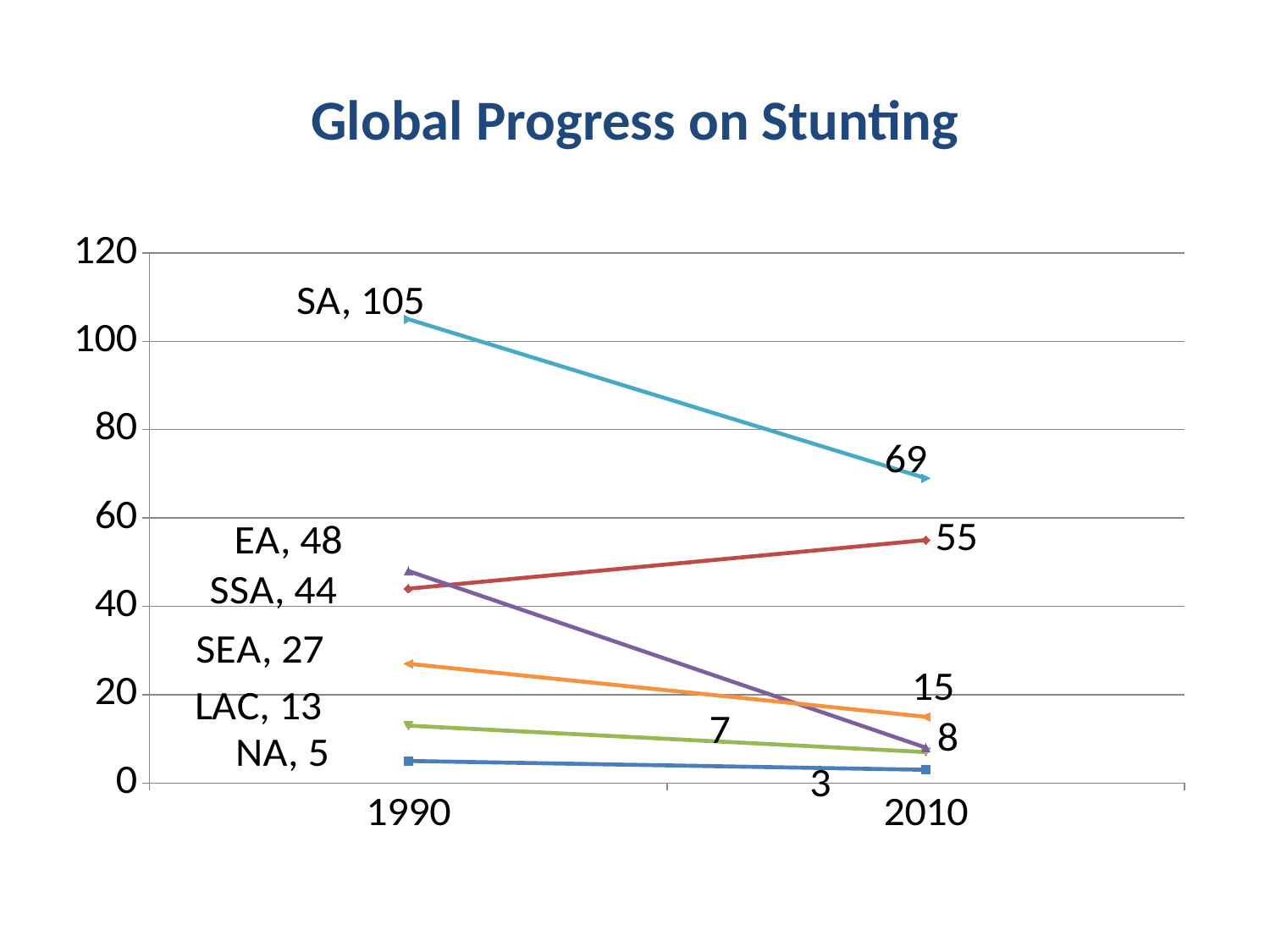
How many points are on the x axis? 2 Which is larger in 2010, the value for SSA or the value for SA? SA What is the value for EA in 1990? 48 What kind of chart is shown on the slide? line chart Which region has the highest value in 1990? SA What is the title of the chart? Global Progress on Stunting By how much did the value for SA fall from 1990 to 2010? 36 What is the value for SSA in 2010? 55 What is the value for SA in 1990? 105 Does the value for SSA rise or fall from 1990 to 2010? rise Which region has the lowest value in 2010? NA How many regions are plotted on the chart? 6